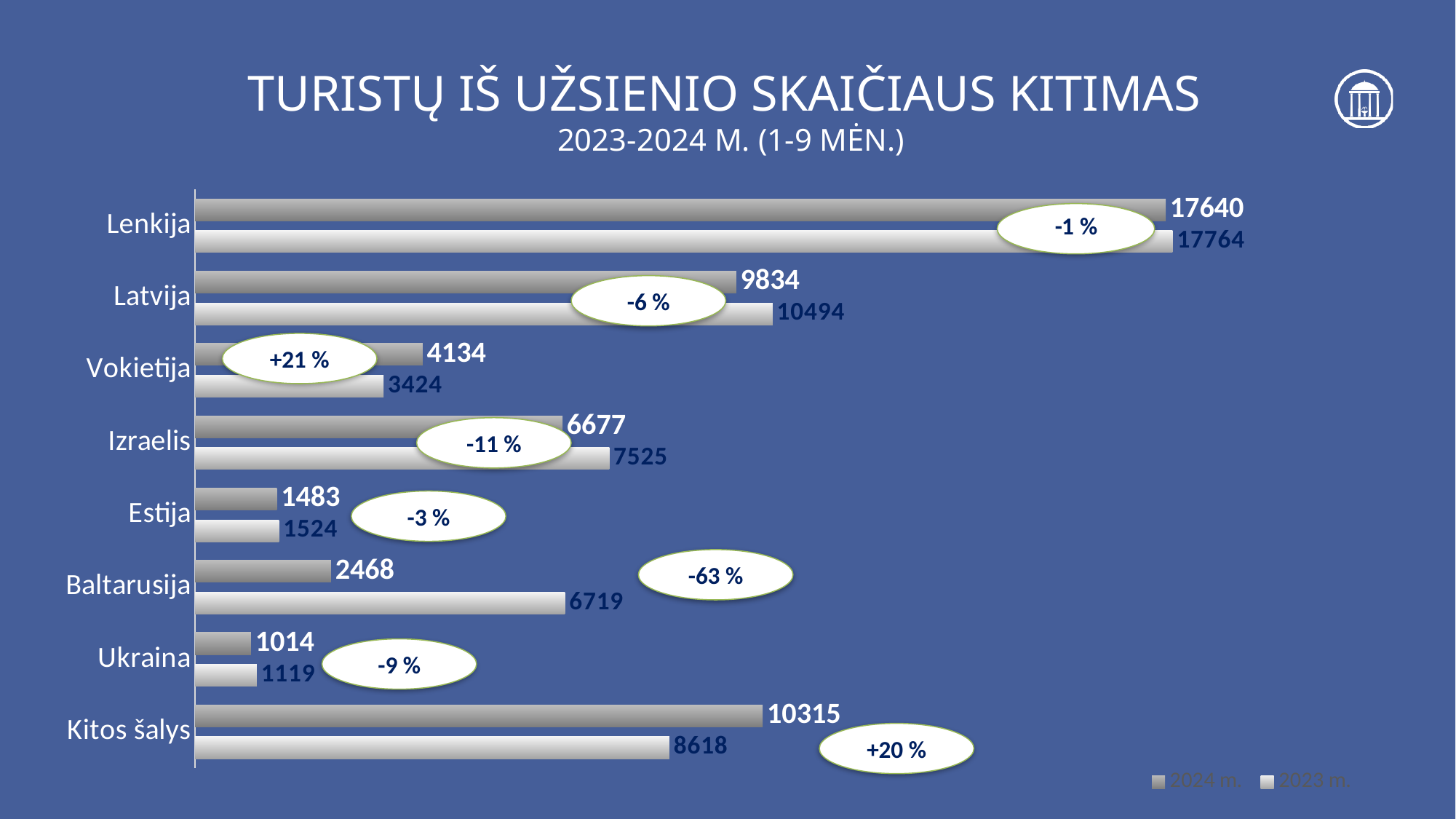
Which category has the highest 2024 m. value? Lenkija What is the 2024 m. value for Kitos šalys? 10315 What is the title of the chart? TURISTŲ IŠ UŽSIENIO SKAIČIAUS KITIMAS 2023-2024 M. (1-9 MĖN.) What is the 2024 m. value for Lenkija? 17640 Which is larger for Vokietija: the 2024 m. value or the 2023 m. value? 2024 m. What is the difference between the 2023 m. and 2024 m. values for Latvija? 660 How many series does the legend list? 2 What kind of chart is shown on the slide? bar chart Which category has the lowest 2023 m. value? Ukraina What is the 2023 m. value for Baltarusija? 6719 How many countries/categories are shown on the chart? 8 What percentage change is shown for Baltarusija? -63 %